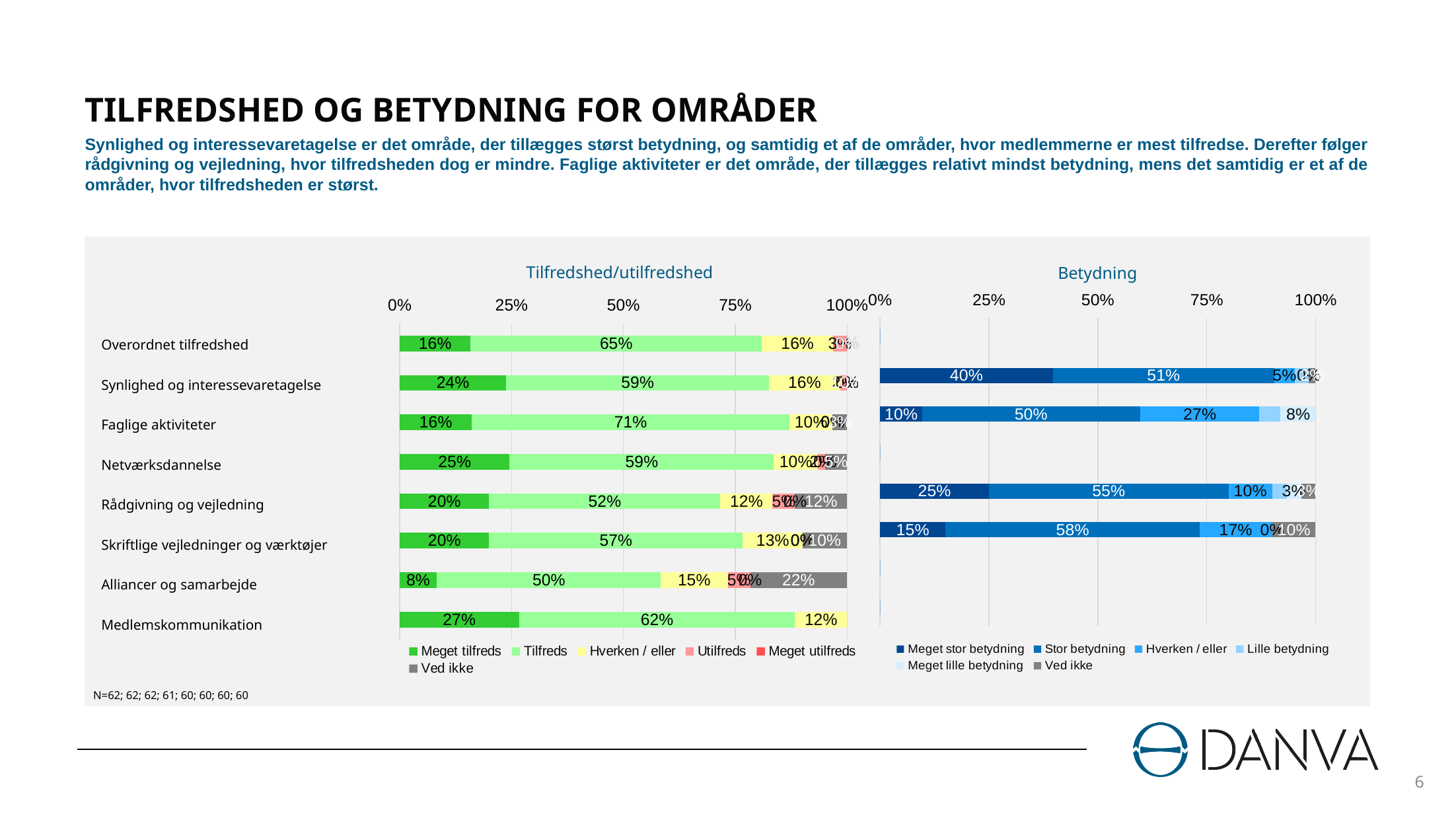
In the Tilfredshed/utilfredshed chart, what is the difference between the Tilfreds value for Overordnet tilfredshed and for Rådgivning og vejledning? 13 percentage points In the Tilfredshed/utilfredshed chart, which category has the highest Meget tilfreds value? Medlemskommunikation How many series does the legend of the Betydning chart list? 6 What kind of chart is the Tilfredshed/utilfredshed chart? Stacked bar chart How many series does the legend of the Tilfredshed/utilfredshed chart list? 6 In the Tilfredshed/utilfredshed chart, what is the Meget tilfreds value for Medlemskommunikation? 27% In the Betydning chart, what is the Meget stor betydning value for Synlighed og interessevaretagelse? 40% In the Tilfredshed/utilfredshed chart, which has the larger Ved ikke value: Alliancer og samarbejde or Rådgivning og vejledning? Alliancer og samarbejde In the Tilfredshed/utilfredshed chart, which category has the lowest Meget tilfreds value? Alliancer og samarbejde In the Betydning chart, what is the Stor betydning value for Skriftlige vejledninger og værktøjer? 58% How many categories are listed on the Tilfredshed/utilfredshed chart? 8 In the Tilfredshed/utilfredshed chart, what is the Tilfreds value for Faglige aktiviteter? 71%